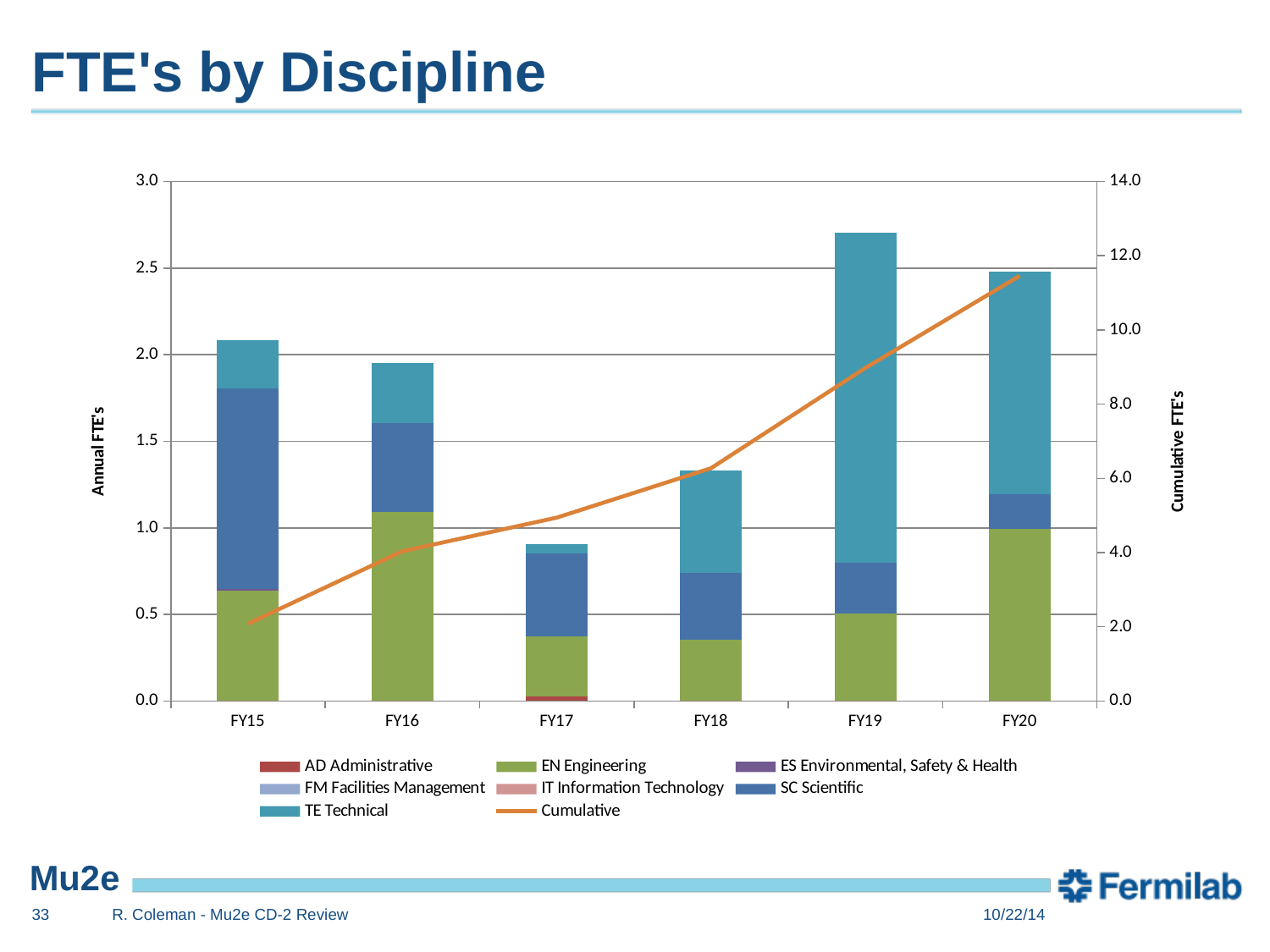
Is the total annual FTE's for FY19 greater or less than 2.5? greater How many fiscal years are shown on the x axis? 6 Does the Cumulative line rise or fall from FY15 to FY20? rise Is the Cumulative value at FY20 greater or less than 10.0? greater Which fiscal year has the tallest stacked bar of annual FTE's? FY19 Is the Cumulative value at FY15 greater or less than 4.0? less How many entries does the legend list? 8 Which has the larger total annual FTE's, FY17 or FY18? FY18 Which fiscal year has the shortest stacked bar of annual FTE's? FY17 What kind of chart is used to show the annual FTE's by discipline? bar chart What is the title of the chart? FTE's by Discipline